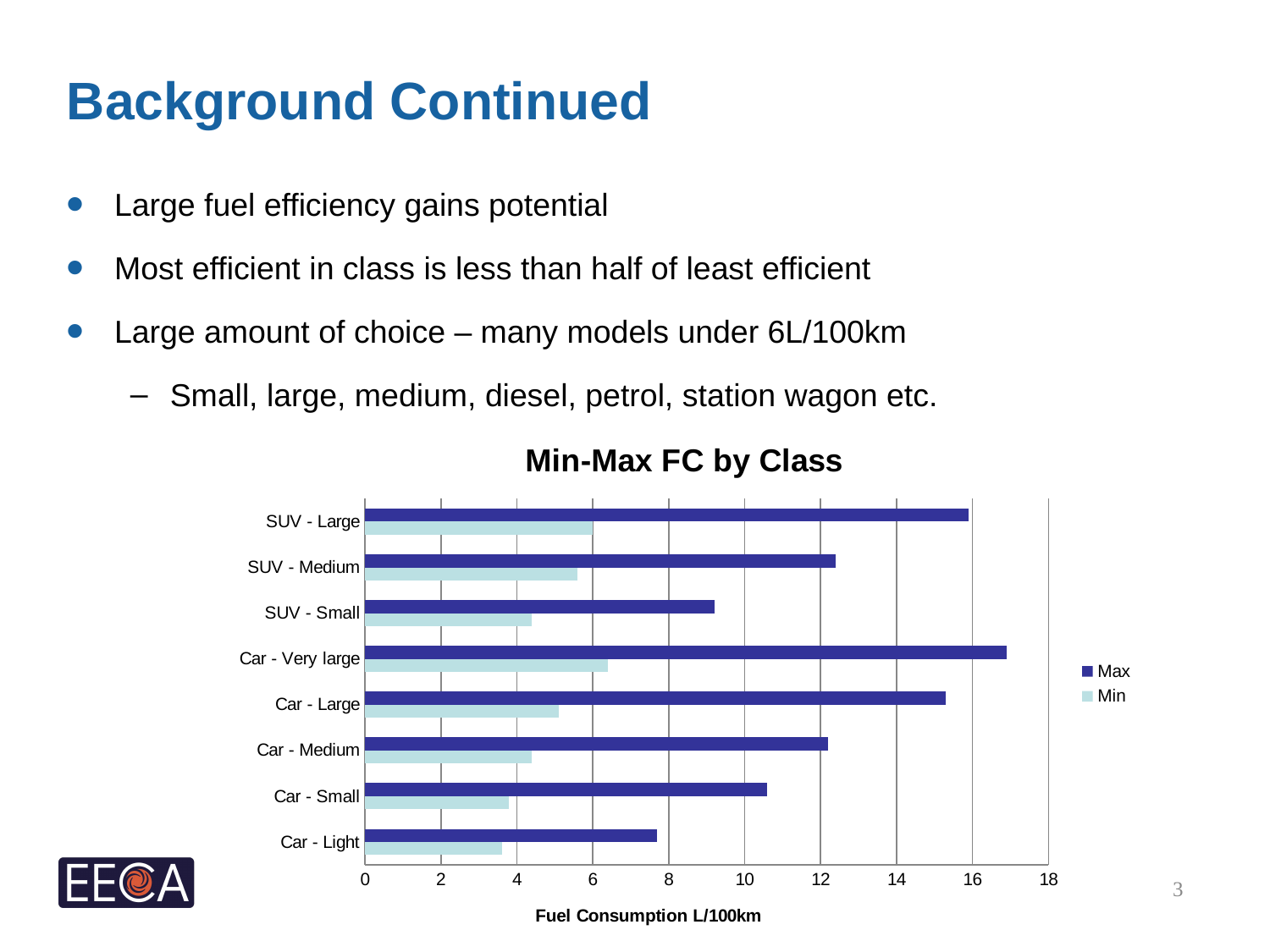
Which vehicle class has the highest Max fuel consumption? Car - Very large Is the Max value for Car - Small greater or less than 10? greater Is the Max value for SUV - Large greater or less than 14? greater What kind of chart is shown on the slide? Bar chart Which vehicle class has the lowest Max fuel consumption? Car - Light What is the label of the horizontal axis of the chart? Fuel Consumption L/100km Is the Max value for Car - Light greater or less than 8? less Which is larger, the Max value for SUV - Small or the Max value for Car - Small? Car - Small How many vehicle classes are shown on the chart? 8 How many series does the chart's legend list? 2 What is the title of the chart? Min-Max FC by Class